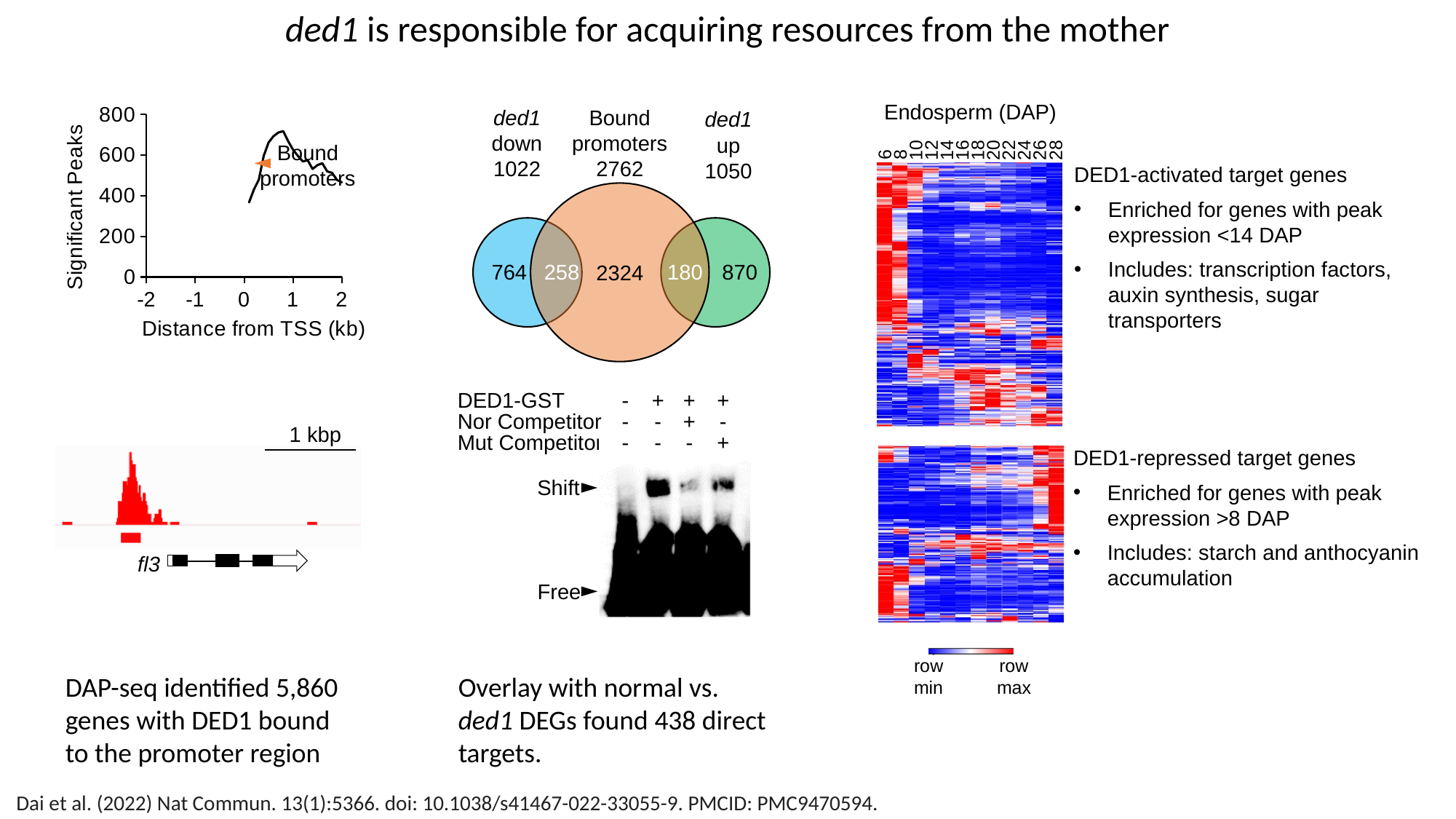
In the Endosperm (DAP) heatmaps, how many DAP time-point columns are shown? 12 In the Venn diagram, how many genes are in the ded1 down set only (not overlapping bound promoters)? 764 In the top-left chart, is the peak value of the curve greater or less than 800? less In the Venn diagram, what is the difference between the ded1 up total (1050) and the ded1 down total (1022)? 28 In the Venn diagram, how many genes are in the overlap between ded1 up and bound promoters? 180 In the Venn diagram, what is the total number of bound promoters? 2762 In the top-left chart, what is the label of the y axis? Significant Peaks In the Endosperm (DAP) heatmaps, what is the earliest DAP time point shown? 6 In the Venn diagram, what is the sum of the two overlap regions (258 and 180)? 438 In the Venn diagram, which overlap is larger: ded1 down with bound promoters, or ded1 up with bound promoters? ded1 down with bound promoters In the top-left chart, is the peak value of the curve greater or less than 600? greater In the top-left chart, what is the label of the x axis? Distance from TSS (kb)